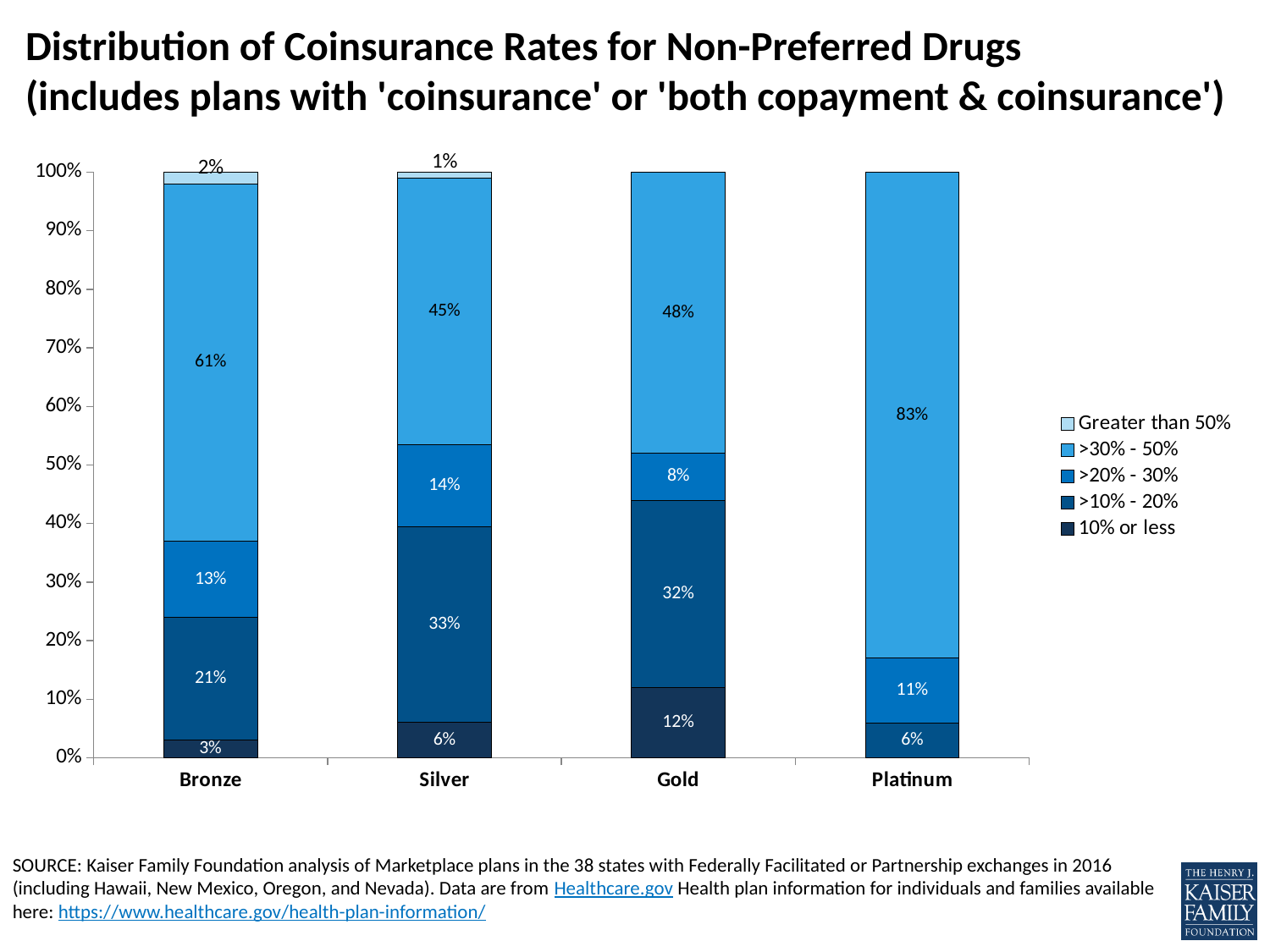
Which plan type has the largest share of plans in the >30% - 50% coinsurance range? Platinum What share of Bronze plans have a coinsurance rate greater than 50%? 2% How many plan categories are shown on the x axis? 4 How many series does the legend list? 5 What share of Gold plans have a coinsurance rate of 10% or less? 12% Which has a larger share of plans with coinsurance of 10% or less, Bronze or Silver? Silver What is the value of the largest segment in the Platinum bar? 83% Which legend entry is listed first? Greater than 50% What is the difference between the >10% - 20% share for Gold and for Bronze? 11 percentage points What share of Bronze plans have a coinsurance rate of >30% - 50%? 61% What share of Silver plans have a coinsurance rate of >10% - 20%? 33% What kind of chart is shown on the slide? Stacked bar chart